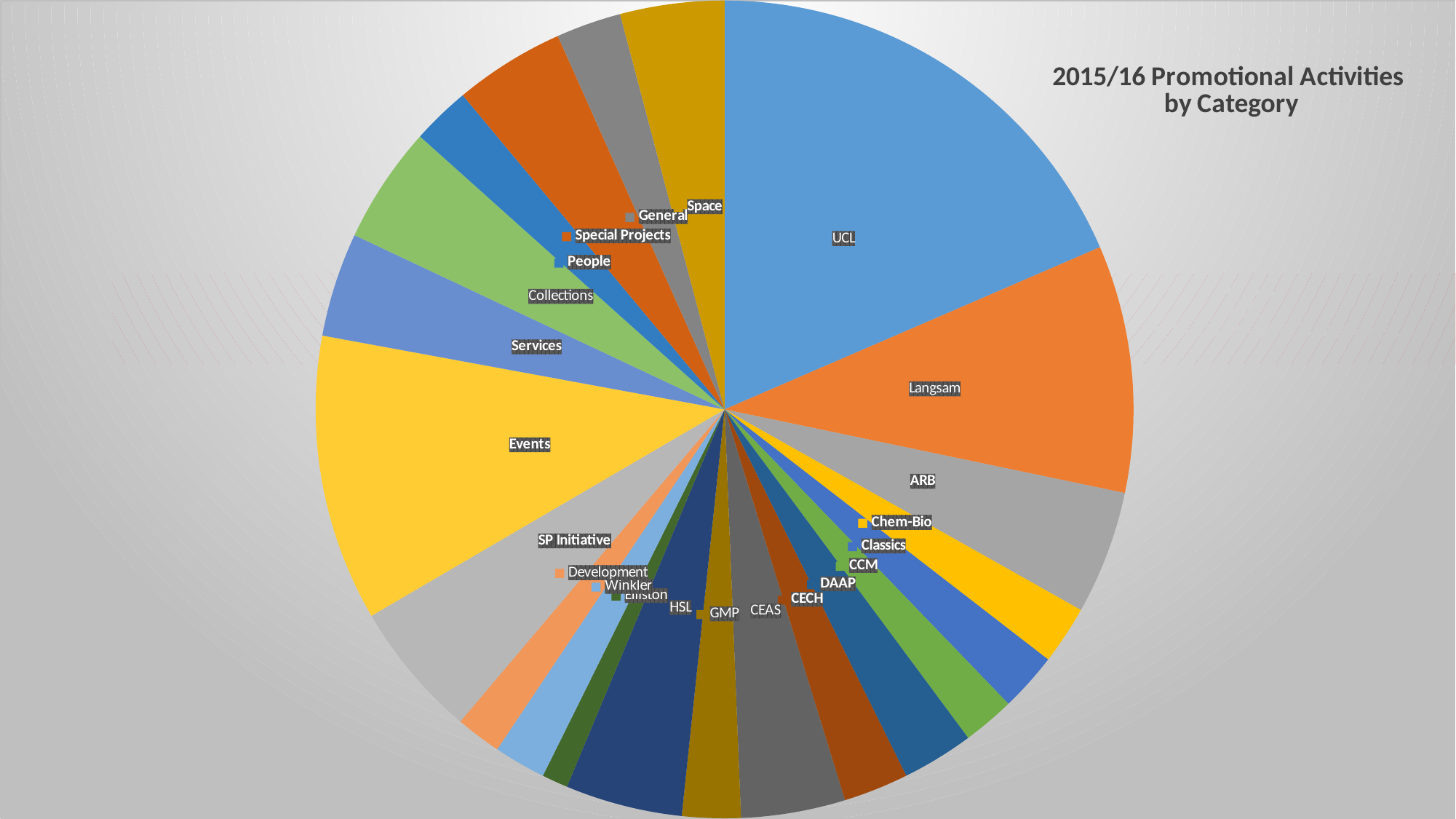
Which slice is larger, Collections or People? Collections What is the title of the chart? 2015/16 Promotional Activities by Category Which slice is larger, ARB or Chem-Bio? ARB What kind of chart is shown on the slide? pie chart Which slice is larger, Langsam or ARB? Langsam Which category has the smallest slice of the pie? Elliston How many categories (slices) are shown in the pie chart? 22 Which category has the largest slice of the pie? UCL